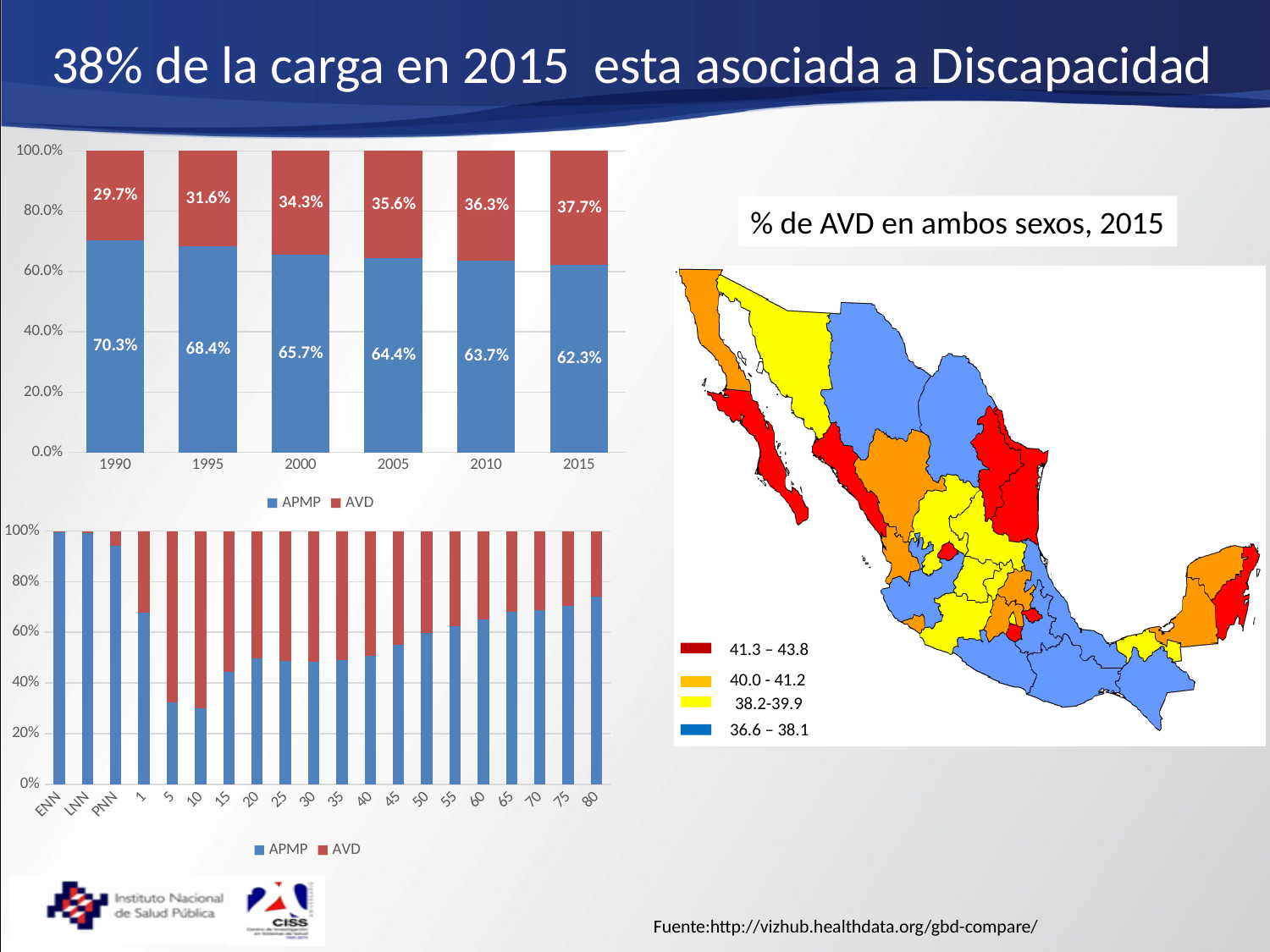
In the top-left stacked bar chart by year, which year has the lowest AVD value? 1990 In the top-left stacked bar chart by year, what is the difference between the AVD values for 2015 and 1990? 8.0% In the top-left stacked bar chart by year, does the AVD share rise or fall from 1990 to 2015? rise What kind of chart is the bottom-left chart by age group? stacked bar chart In the top-left stacked bar chart by year, what is the APMP value for 1990? 70.3% In the bottom-left stacked bar chart by age group, is the APMP value for the category 5 greater or less than 40%? less In the top-left stacked bar chart by year, how many years are shown on the x axis? 6 In the bottom-left stacked bar chart by age group, how many categories are shown on the x axis? 20 In the top-left stacked bar chart by year, which year has the highest APMP value? 1990 In the top-left stacked bar chart by year, is the APMP value larger in 2000 or in 2010? 2000 In the top-left stacked bar chart by year, how many series does the legend list? 2 In the top-left stacked bar chart by year, what is the AVD value for 2015? 37.7%